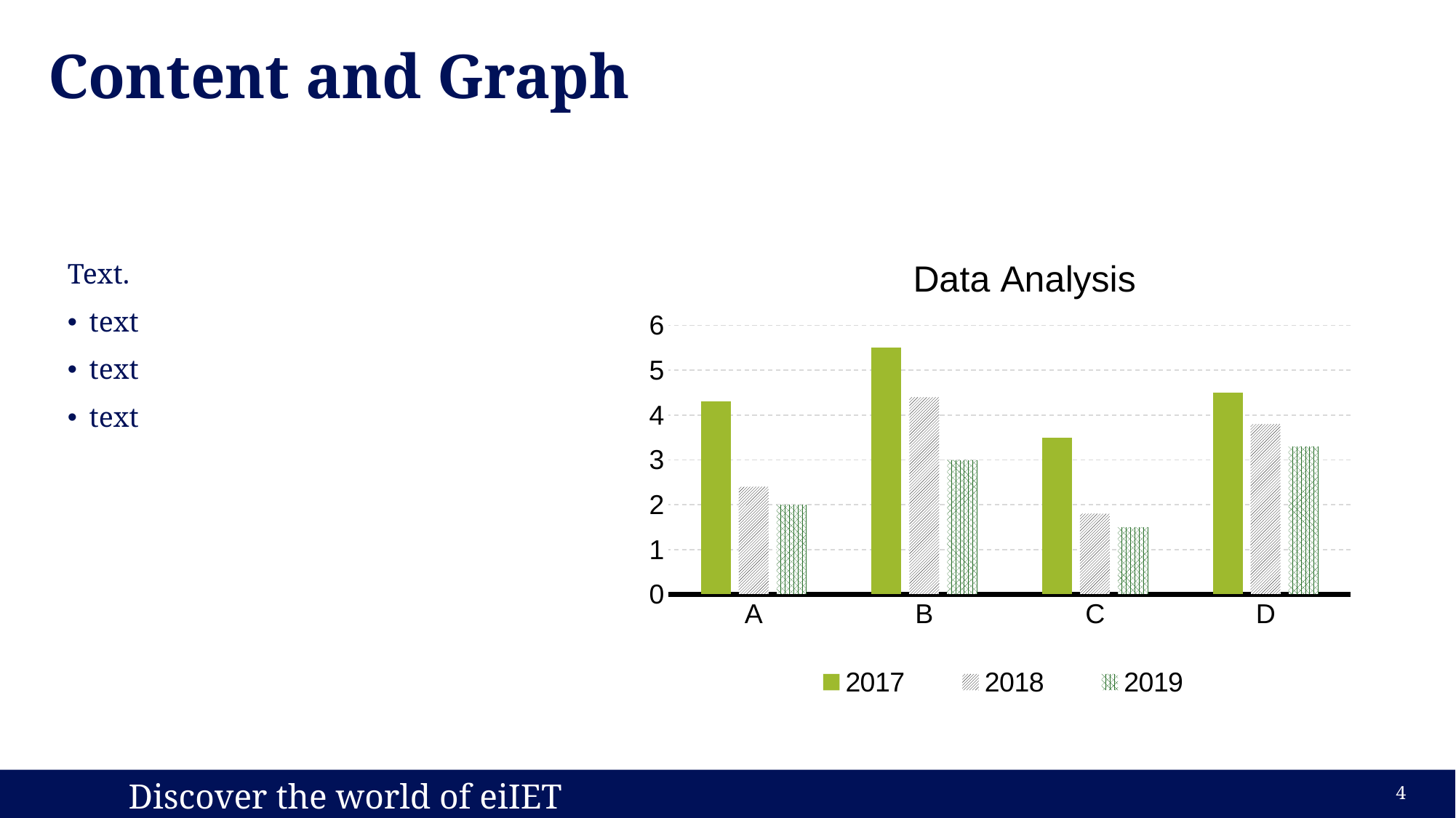
How many categories are shown on the x axis? 4 How many series does the legend list? 3 Is the value for C in 2018 greater or less than 2? less Is the value for D in 2017 greater or less than 4? greater What type of chart is shown on the slide? bar chart Which category has the lowest value for 2018? C What is the title of the chart? Data Analysis Which category has the lowest value for 2019? C Which is larger, the 2017 value for B or the 2017 value for C? B Which category has the highest value for 2017? B Is the value for B in 2017 greater or less than 5? greater Within each category, do the values rise or fall from 2017 to 2019? fall